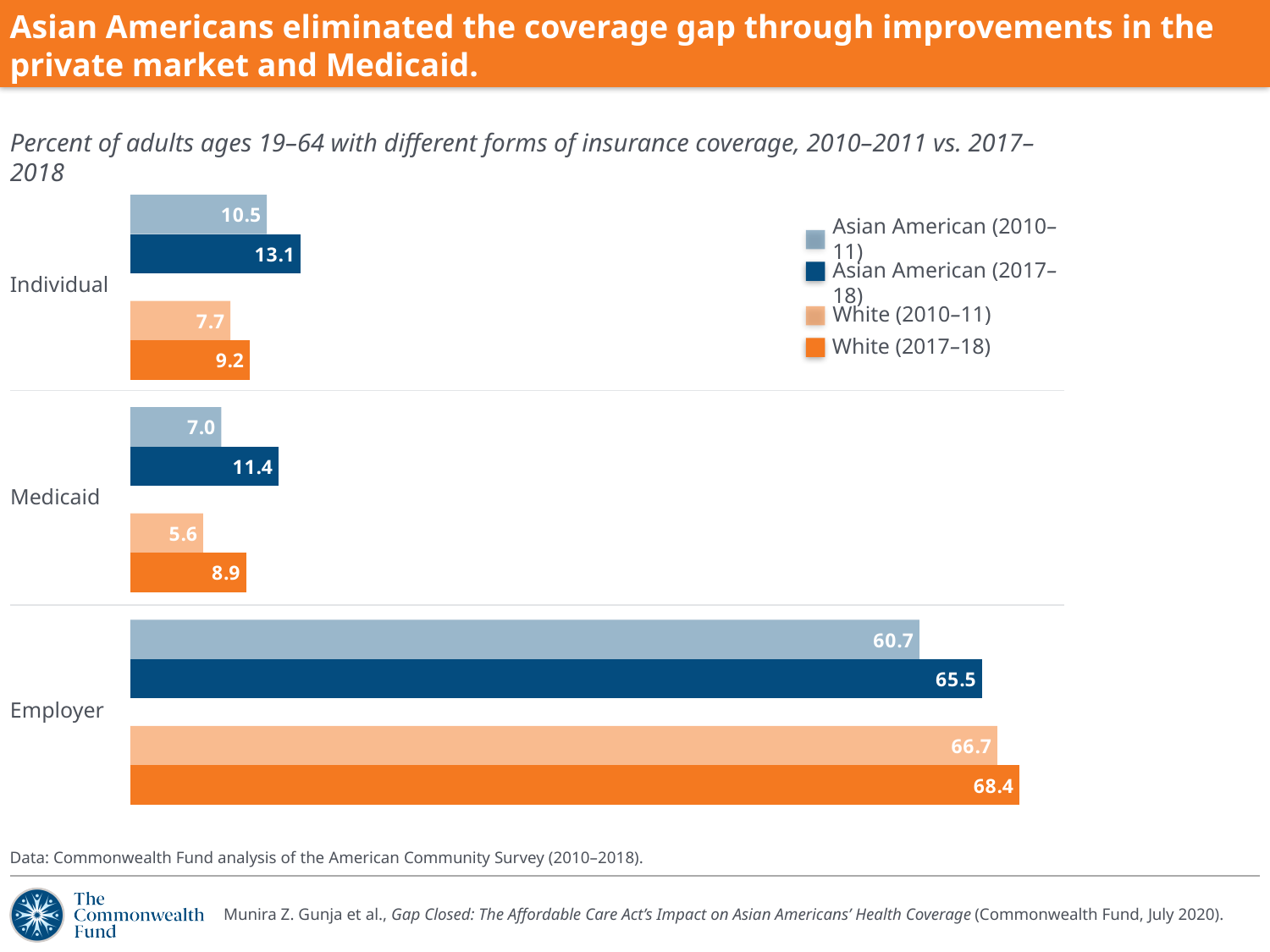
In the Individual category, which is larger: the Asian American (2017–18) value or the White (2017–18) value? Asian American (2017–18) How many categories are shown on the chart? 3 What is the value for White (2010–11) in the Medicaid category? 5.6 How many series does the legend list? 4 What is the value for Asian American (2017–18) in the Individual category? 13.1 What is the value for White (2017–18) in the Employer category? 68.4 Which category has the lowest value for White (2010–11)? Medicaid What kind of chart is shown on the slide? Bar chart Which category has the highest value for Asian American (2017–18)? Employer What is the difference between the White (2017–18) and Asian American (2017–18) values in the Employer category? 2.9 What is the difference between the Asian American (2017–18) and Asian American (2010–11) values in the Medicaid category? 4.4 What is the value for Asian American (2010–11) in the Employer category? 60.7